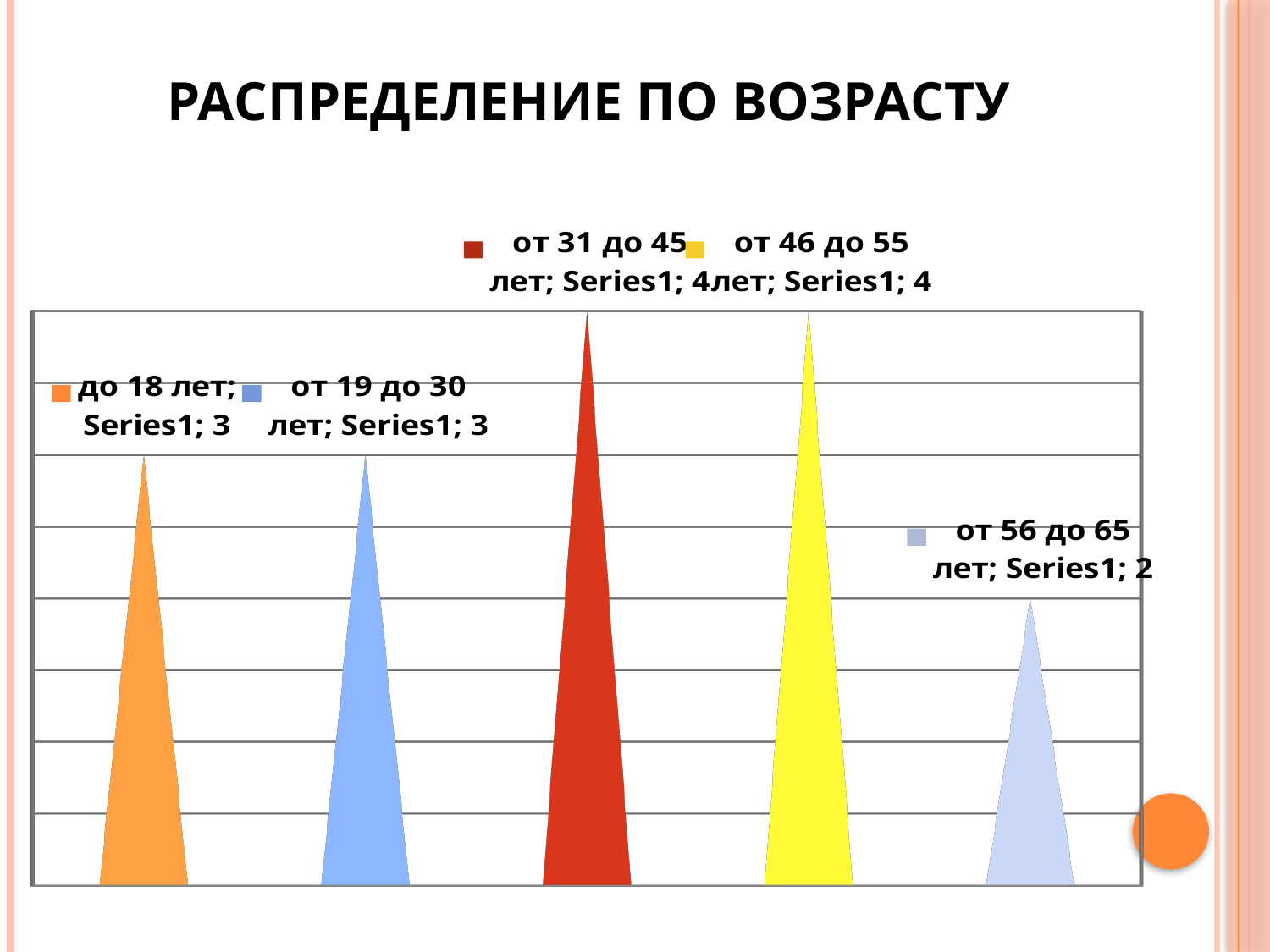
What kind of chart is shown on the slide? bar chart What is the difference between the values for "от 31 до 45 лет" and "от 56 до 65 лет"? 2 What is the title of the slide? РАСПРЕДЕЛЕНИЕ ПО ВОЗРАСТУ What is the value for the category "от 46 до 55 лет"? 4 What is the value for the category "от 31 до 45 лет"? 4 Which age category has the lowest value? от 56 до 65 лет What is the value for the category "до 18 лет"? 3 What is the value for the category "от 19 до 30 лет"? 3 What is the difference between the values for "до 18 лет" and "от 56 до 65 лет"? 1 What is the value for the category "от 56 до 65 лет"? 2 Which is larger, the value for "от 46 до 55 лет" or the value for "от 19 до 30 лет"? от 46 до 55 лет How many age categories are shown in the chart? 5